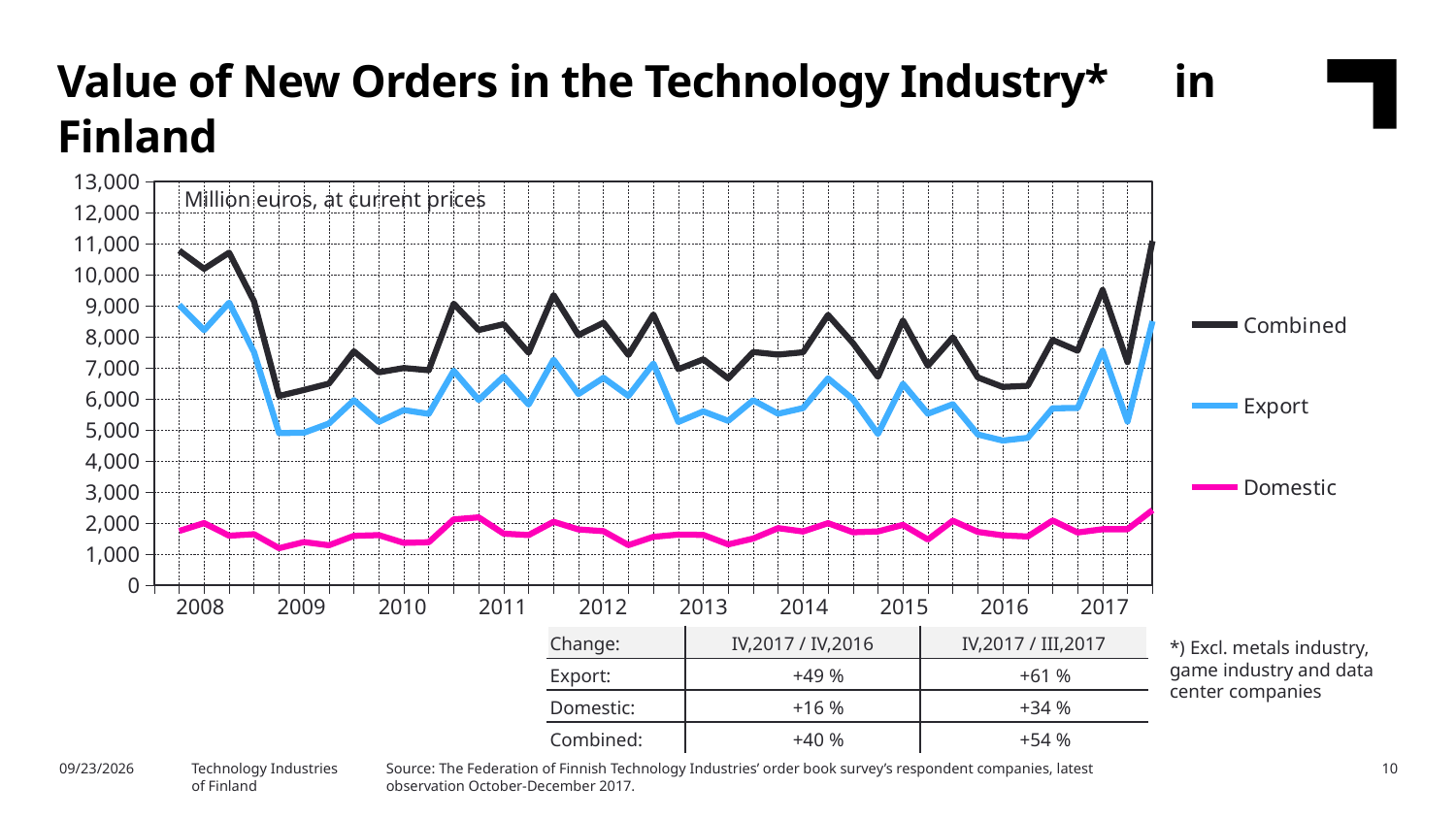
Which series has the highest values throughout the chart? Combined Is the value of the Domestic series at the end of 2017 greater or less than 2,000? greater Does the Combined series rise or fall from the start of 2008 to the start of 2009? fall Which series has the lowest values throughout the chart? Domestic What type of chart is shown on the slide? line chart Is the value of the Export series at the start of 2009 greater or less than 6,000? less Is the value of the Combined series at the start of 2008 greater or less than 10,000? greater What unit label is printed inside the plot area? Million euros, at current prices What are the three series named in the legend? Combined, Export, Domestic How many series does the legend list? 3 Which is larger at the start of 2008, the Combined value or the Export value? Combined